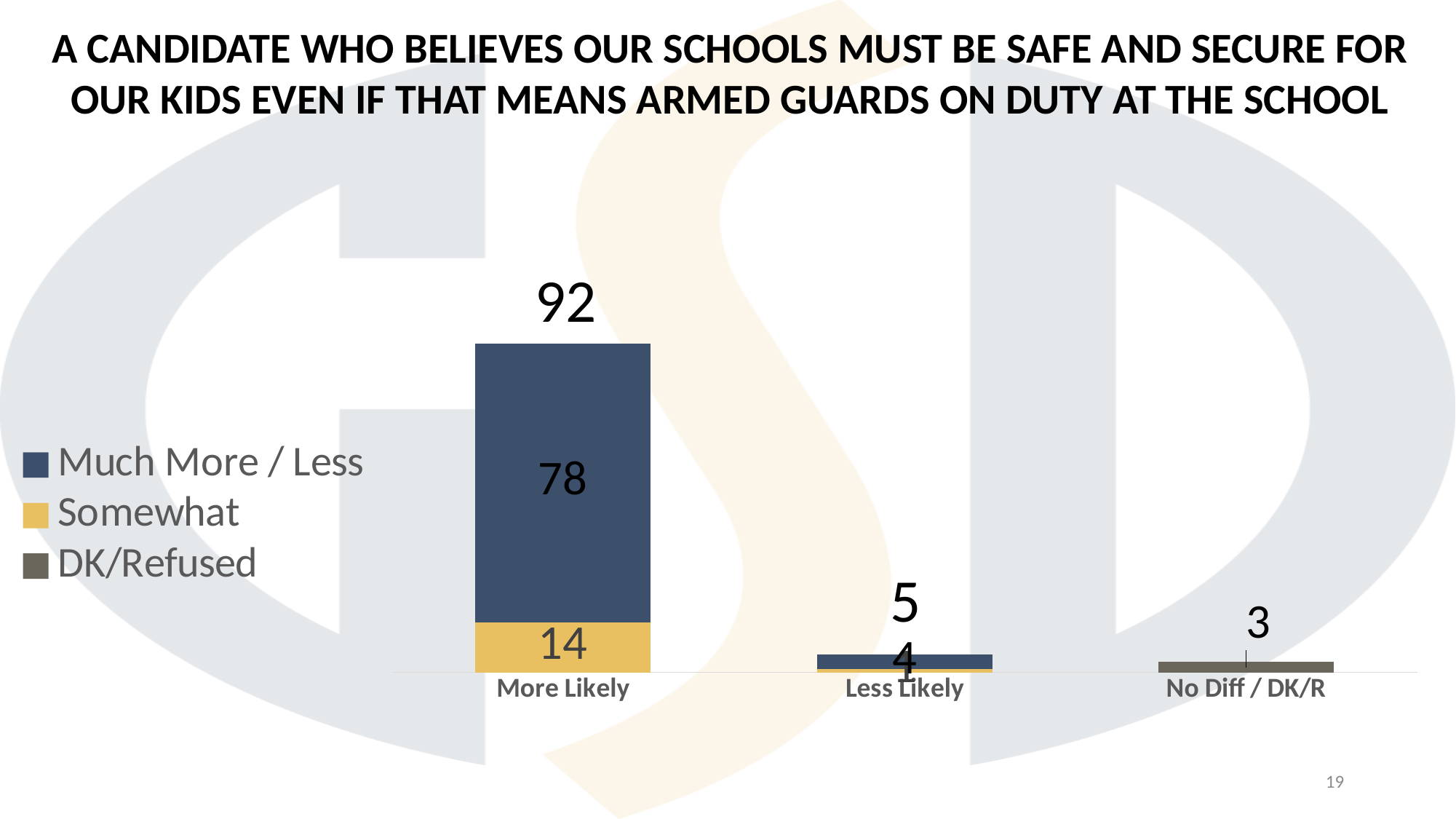
What is the value of the Much More / Less segment for More Likely? 78 What kind of chart is shown on the slide? Stacked bar chart How many categories are shown on the x axis? 3 Which category has the lowest total? No Diff / DK/R What is the total value of the More Likely bar? 92 Which is larger, the total for More Likely or the total for Less Likely? More Likely What is the total value shown above the Less Likely bar? 5 What is the value of the Somewhat segment for More Likely? 14 Which category has the highest total? More Likely How many series does the legend list? 3 What is the difference between the Much More / Less and Somewhat segments for More Likely? 64 What is the value for No Diff / DK/R? 3